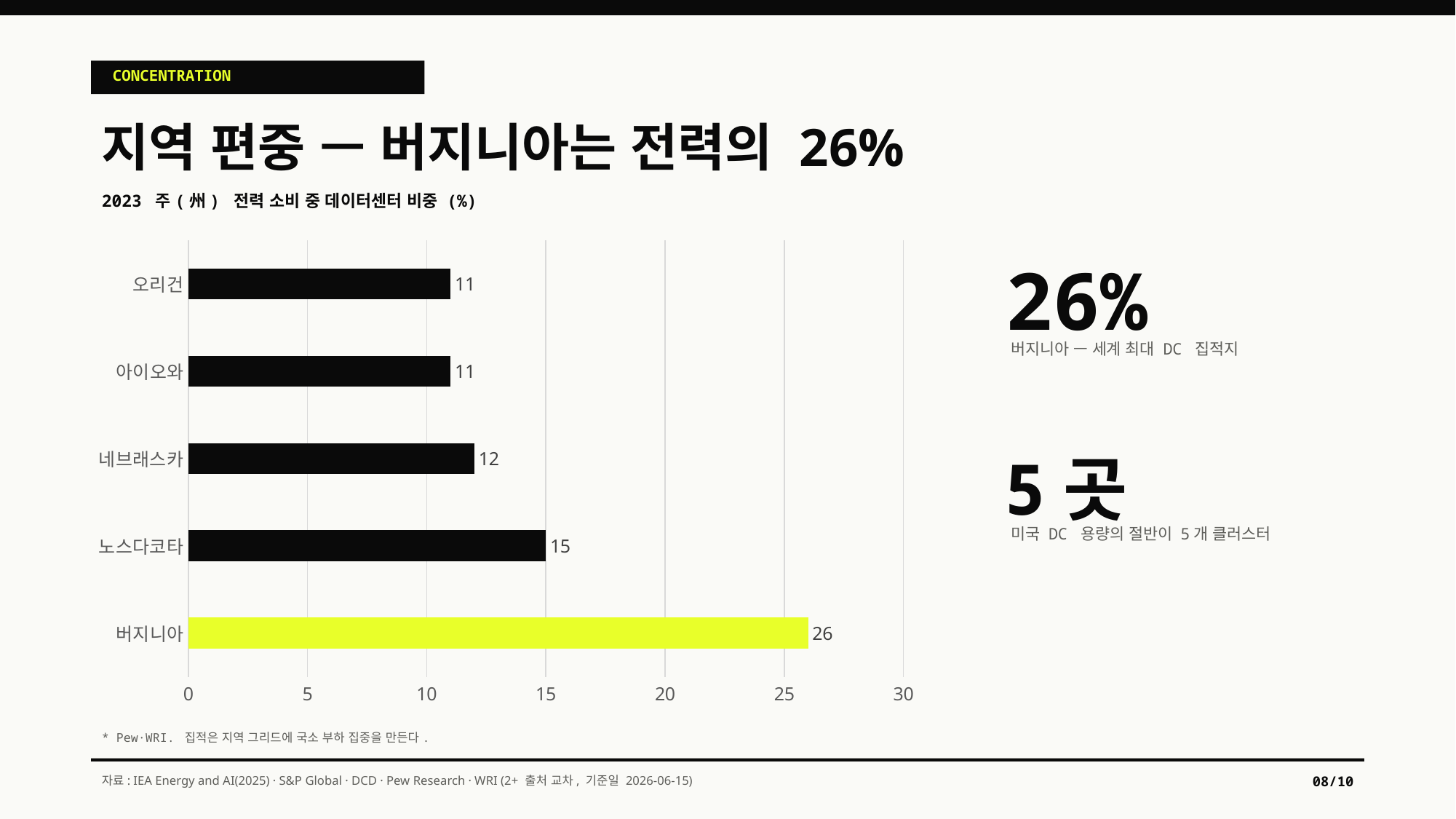
What is the value for 네브래스카? 12 What is the value for 버지니아? 26 Which is larger, the value for 노스다코타 or the value for 네브래스카? 노스다코타 How many states are shown in the chart? 5 What is the difference between the values for 네브래스카 and 아이오와? 1 What is the value for 노스다코타? 15 Is the value for 버지니아 greater or less than 25? greater What is the value for 오리건? 11 What kind of chart is shown on the slide? bar chart Which state has the highest value in the chart? 버지니아 What is the difference between the values for 버지니아 and 노스다코타? 11 Which bar in the chart is highlighted in yellow? 버지니아